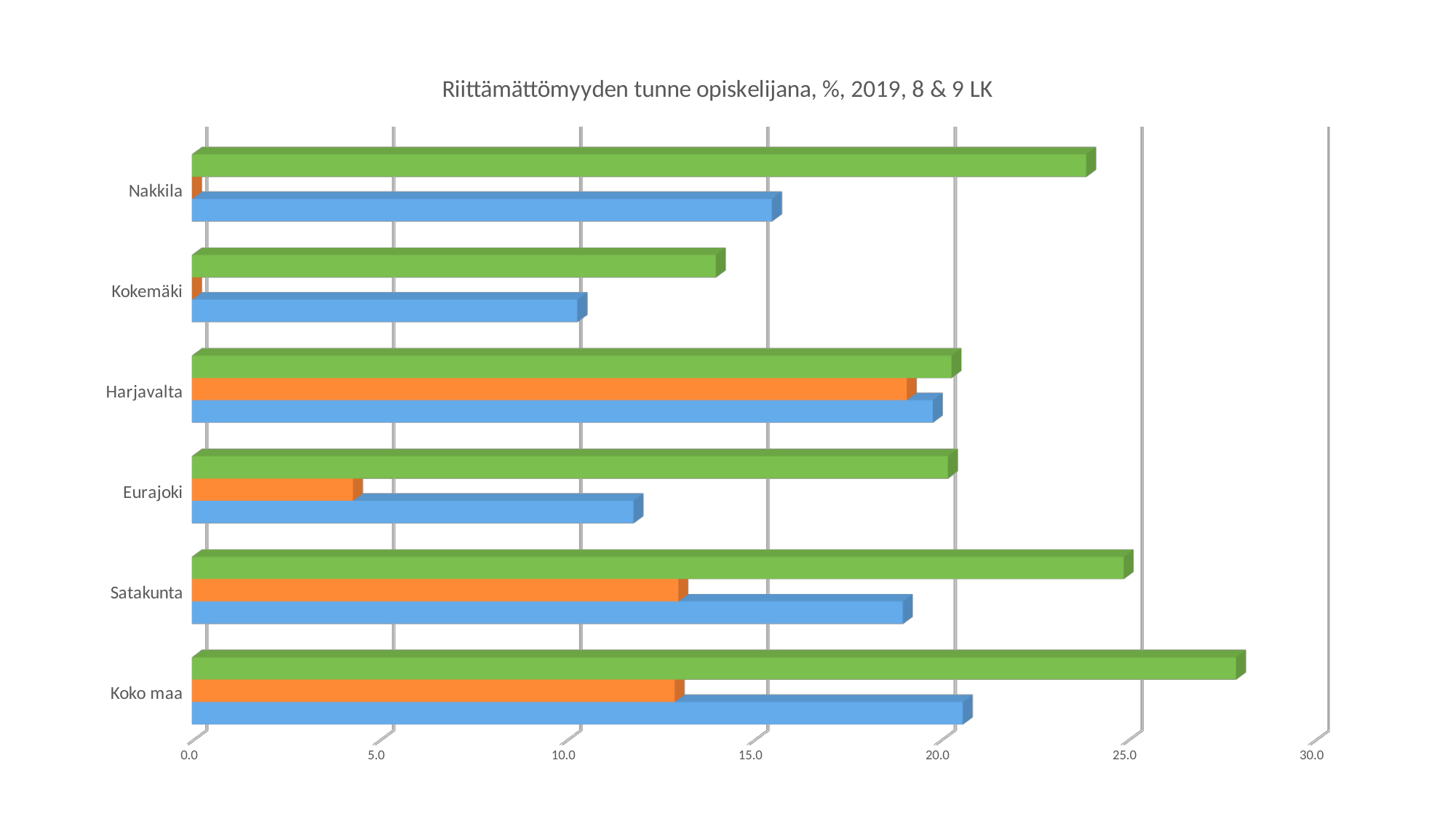
Which is longer, the green bar for Nakkila or the green bar for Kokemäki? Nakkila Which category has the shortest blue bar? Kokemäki Is the green bar for Nakkila greater or less than 20? greater Which category has the longest orange bar? Harjavalta Which category has the shortest green bar? Kokemäki Is the green bar for Koko maa greater or less than 25? greater What is the title of the chart? Riittämättömyyden tunne opiskelijana, %, 2019, 8 & 9 LK How many categories are shown on the vertical axis of the chart? 6 Which is longer, the blue bar for Harjavalta or the blue bar for Eurajoki? Harjavalta Which category has the longest green bar? Koko maa What kind of chart is shown on the slide? bar chart Is the orange bar for Eurajoki greater or less than 5? less